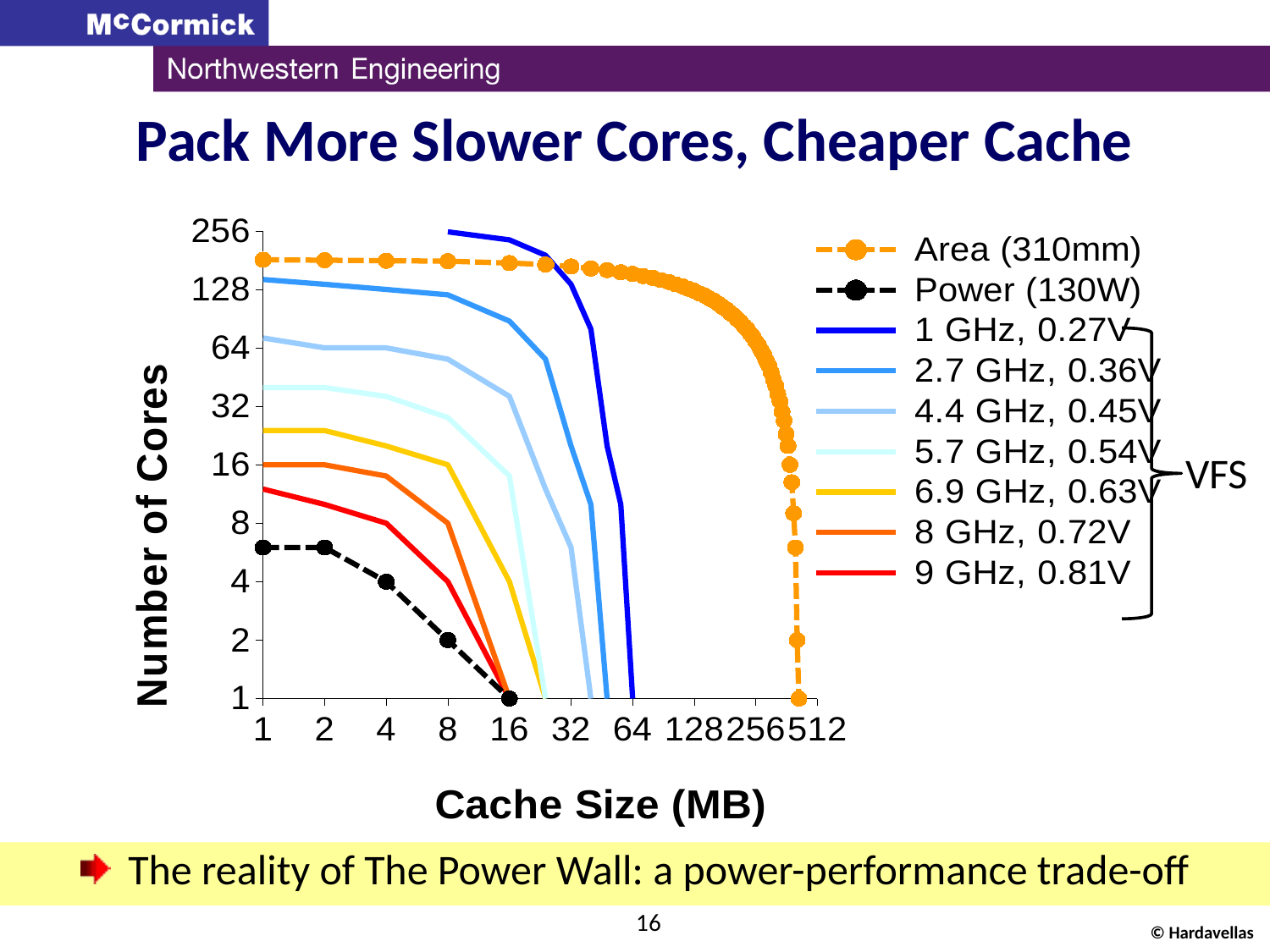
What kind of chart is shown on the slide? line chart Does the number of cores for the Power (130W) series rise or fall as cache size increases? fall What is the number of cores for the 9 GHz, 0.81V series at a cache size of 4 MB? 8 What is the number of cores for the Power (130W) series at a cache size of 4 MB? 4 Is the number of cores for the 9 GHz, 0.81V series at a cache size of 1 MB greater or less than 16? less What is the label of the x axis? Cache Size (MB) How many series does the legend list? 9 What is the number of cores for the Power (130W) series at a cache size of 8 MB? 2 What is the number of cores for the 8 GHz, 0.72V series at a cache size of 1 MB? 16 What is the label of the y axis? Number of Cores At a cache size of 1 MB, which series has more cores: 8 GHz, 0.72V or 9 GHz, 0.81V? 8 GHz, 0.72V What is the number of cores for the Power (130W) series at a cache size of 16 MB? 1